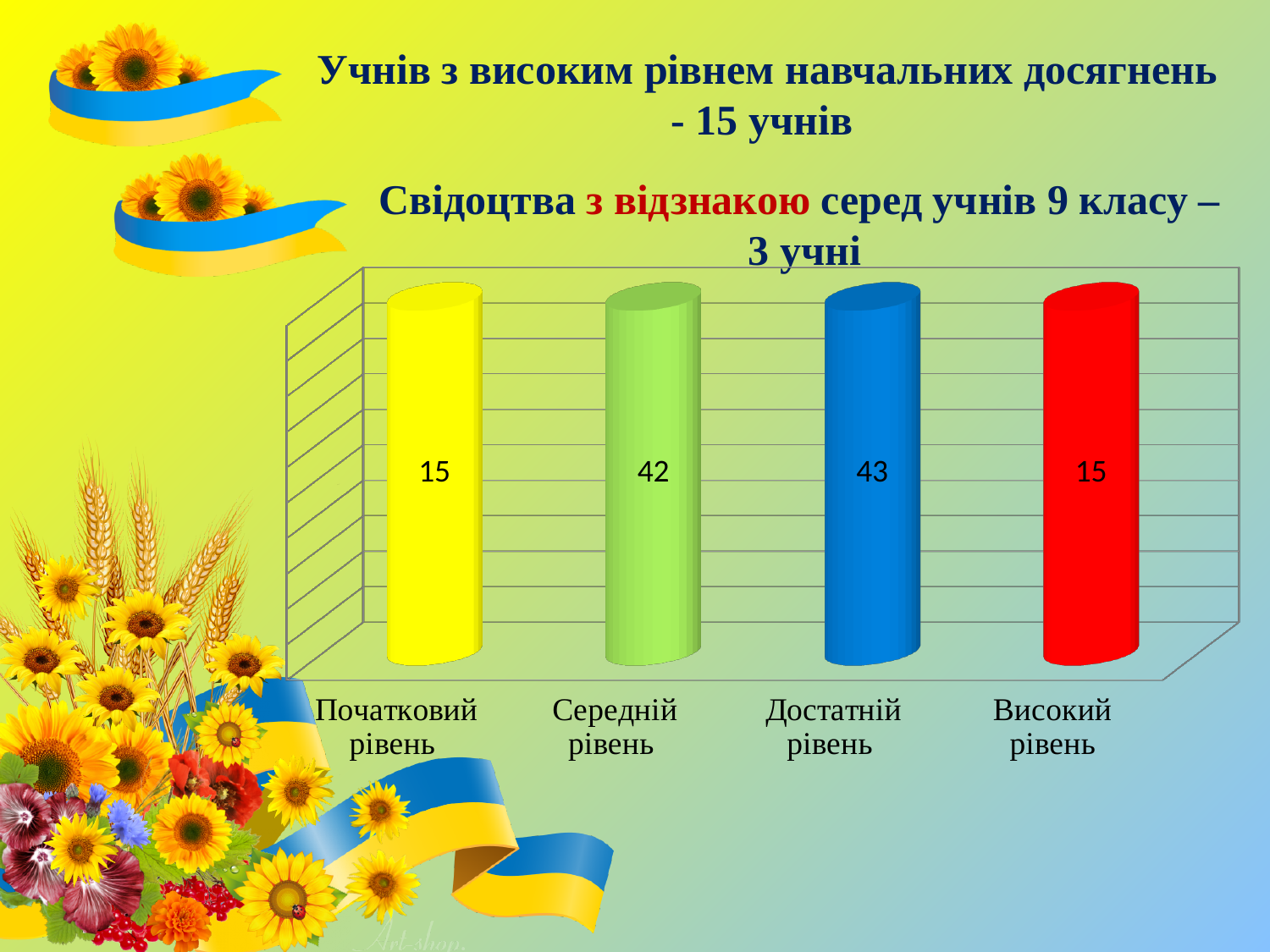
Which category has the highest value according to the data labels? Достатній рівень What is the difference between the values for Достатній рівень and Високий рівень? 28 Which is larger, the value for Середній рівень or the value for Високий рівень? Середній рівень What colour is the bar for Достатній рівень? Blue How many categories are shown in the chart? 4 What is the difference between the values for Достатній рівень and Середній рівень? 1 What value is shown for Достатній рівень? 43 What value is shown for Середній рівень? 42 What value is shown for Високий рівень? 15 What is the difference between the values for Середній рівень and Початковий рівень? 27 What value is shown for Початковий рівень? 15 What kind of chart is shown on the slide? Bar chart